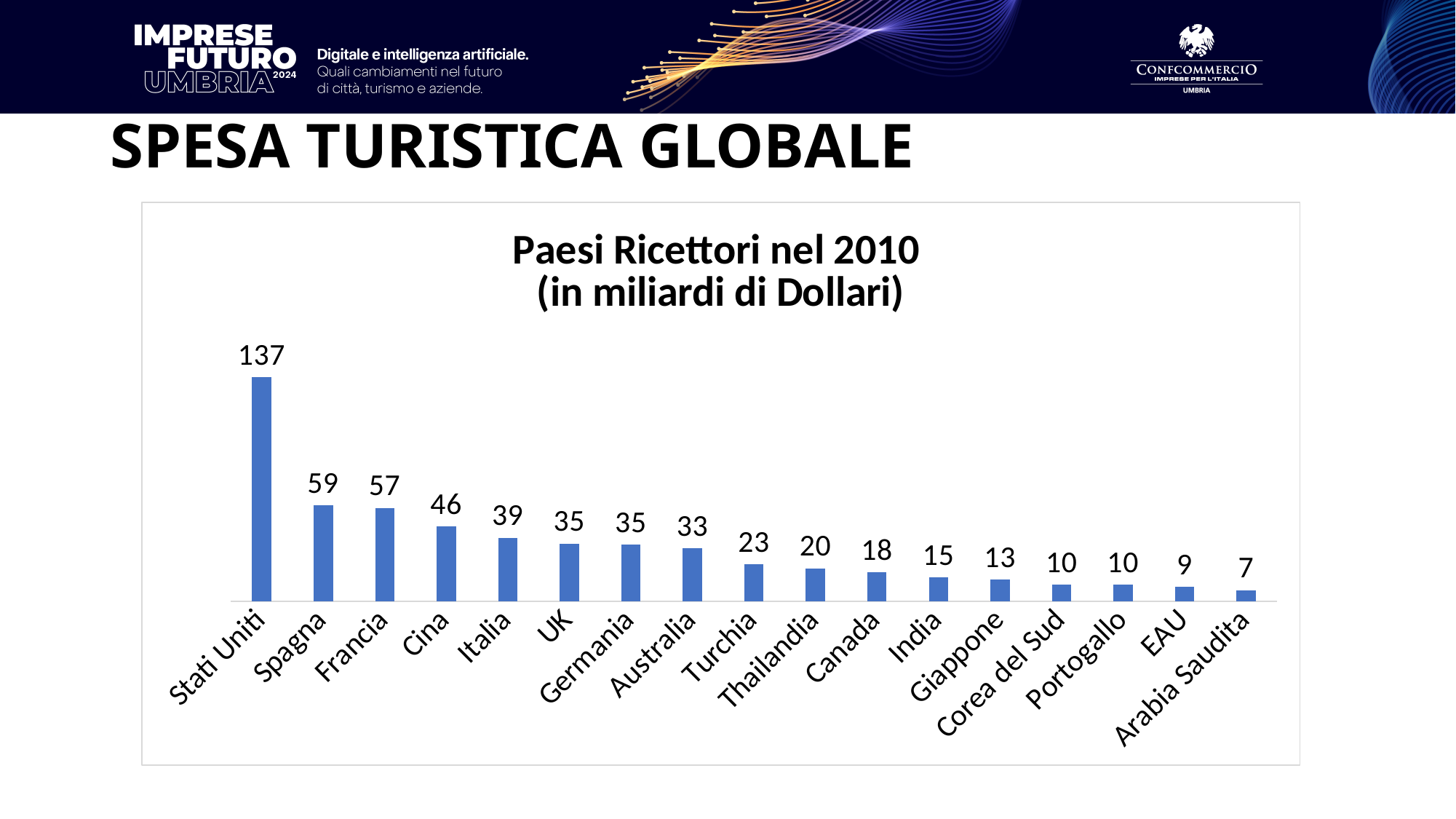
Do the values rise or fall from left to right along the x axis? Fall Which country has the lowest value? Arabia Saudita What kind of chart is shown? Bar chart What is the value for Thailandia? 20 What is the difference between the values for Stati Uniti and Italia? 98 How many countries are shown in the chart? 17 What is the title of the chart? Paesi Ricettori nel 2010 (in miliardi di Dollari) What is the value for Cina? 46 What is the difference between the values for Spagna and Francia? 2 Which country has the highest value? Stati Uniti Which is larger, the value for Turchia or the value for Canada? Turchia What is the value for Stati Uniti? 137